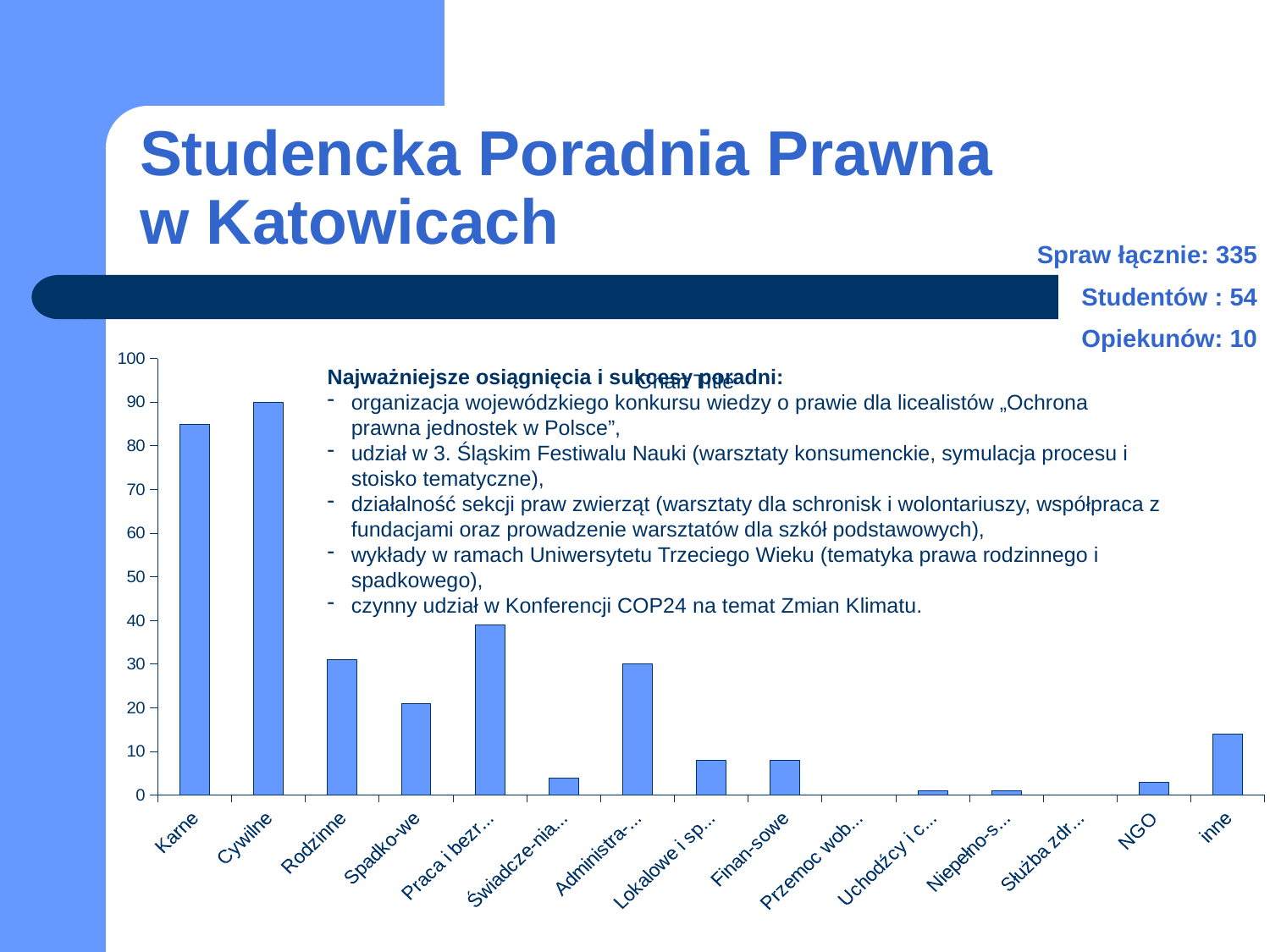
Is the value for Spadko-we greater or less than 30? less What kind of chart is shown on the slide? bar chart Is the value for Rodzinne greater or less than 40? less Which is larger, the value for Praca i bezr... or the value for Spadko-we? Praca i bezr... Is the value for inne greater or less than 10? greater Which is larger, the value for inne or the value for NGO? inne Which is larger, the value for Karne or the value for Rodzinne? Karne What is the maximum value shown on the vertical axis of the chart? 100 Which category has the highest bar in the chart? Cywilne How many categories are shown on the x axis of the chart? 15